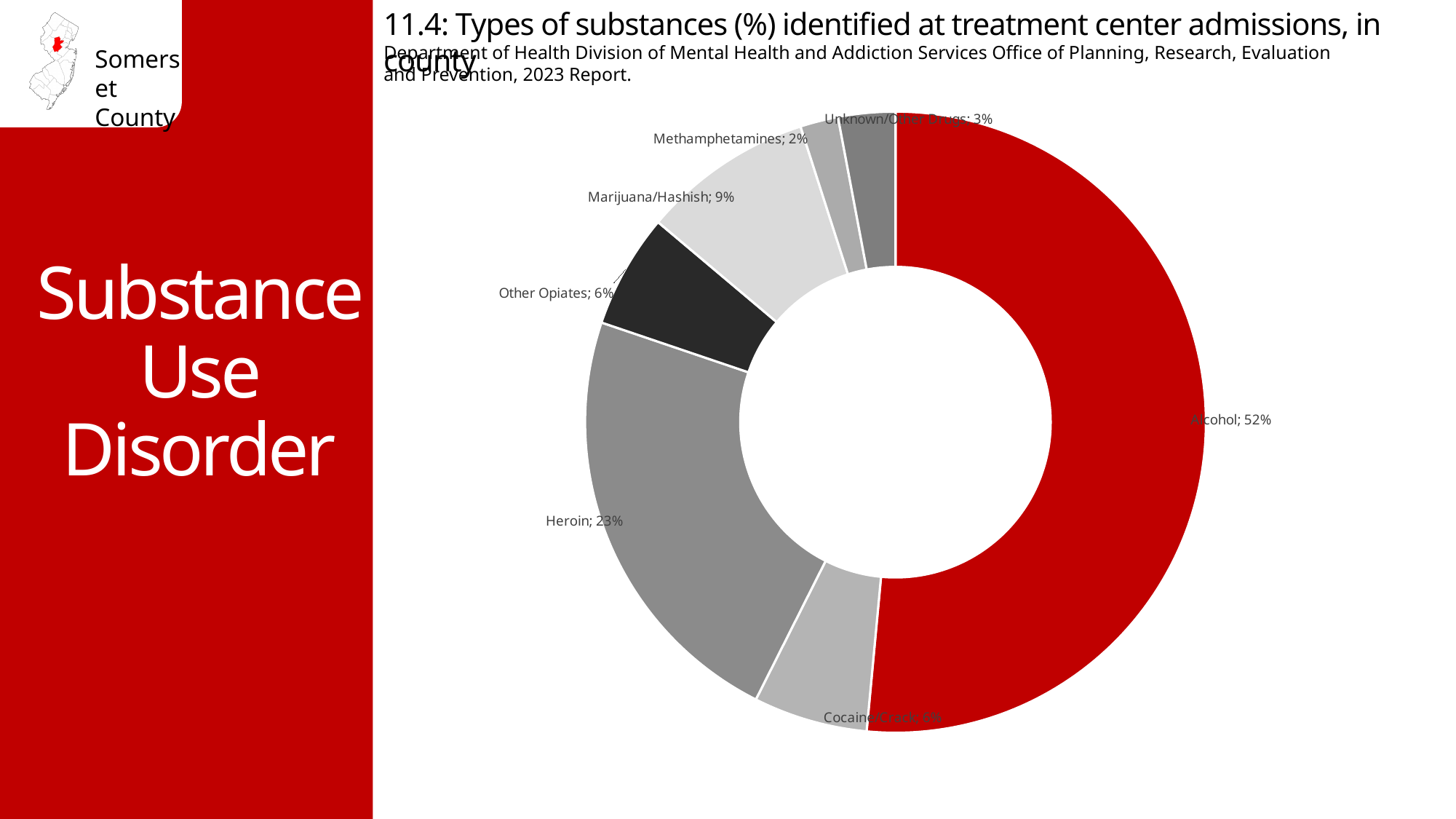
What percentage of treatment center admissions is identified as Alcohol? 52% Which has a larger share, Heroin or Marijuana/Hashish? Heroin What percentage is shown for Methamphetamines? 2% What percentage is shown for Other Opiates? 6% What kind of chart is shown on the slide? Pie (doughnut) chart What is the figure number given in the chart title? 11.4 What percentage is shown for Unknown/Other Drugs? 3% Which has a larger share, Marijuana/Hashish or Other Opiates? Marijuana/Hashish What percentage is shown for Marijuana/Hashish? 9% Which substance has the largest share of admissions? Alcohol What percentage is shown for Heroin? 23% How many percentage points larger is the Alcohol share than the Heroin share? 29